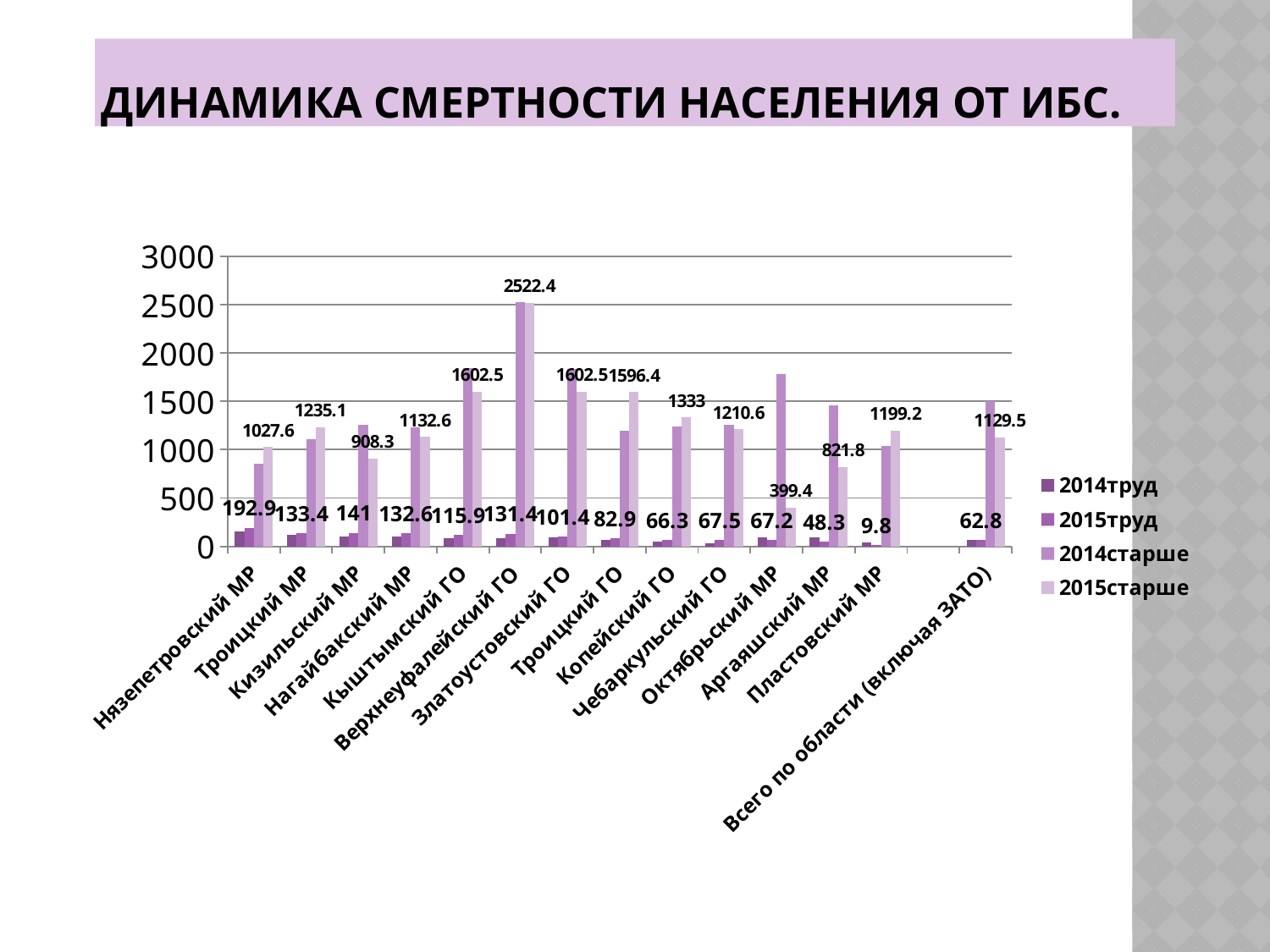
How many categories are shown on the x axis? 14 Which has the larger 2015старше value, Копейский ГО or Чебаркульский ГО? Копейский ГО Which category has the lowest 2015труд value? Пластовский МР What kind of chart is shown on the slide? bar chart Which category has the highest 2015труд value? Нязепетровский МР What is the 2015старше value for Всего по области (включая ЗАТО)? 1129.5 What is the 2015старше value for Верхнеуфалейский ГО? 2522.4 Is the 2014старше value for Октябрьский МР greater or less than 1500? greater What is the 2015труд value for Пластовский МР? 9.8 How many series does the legend list? 4 What is the difference between the 2015старше values for Троицкий МР and Кизильский МР? 326.8 Which category has the highest 2015старше value? Верхнеуфалейский ГО